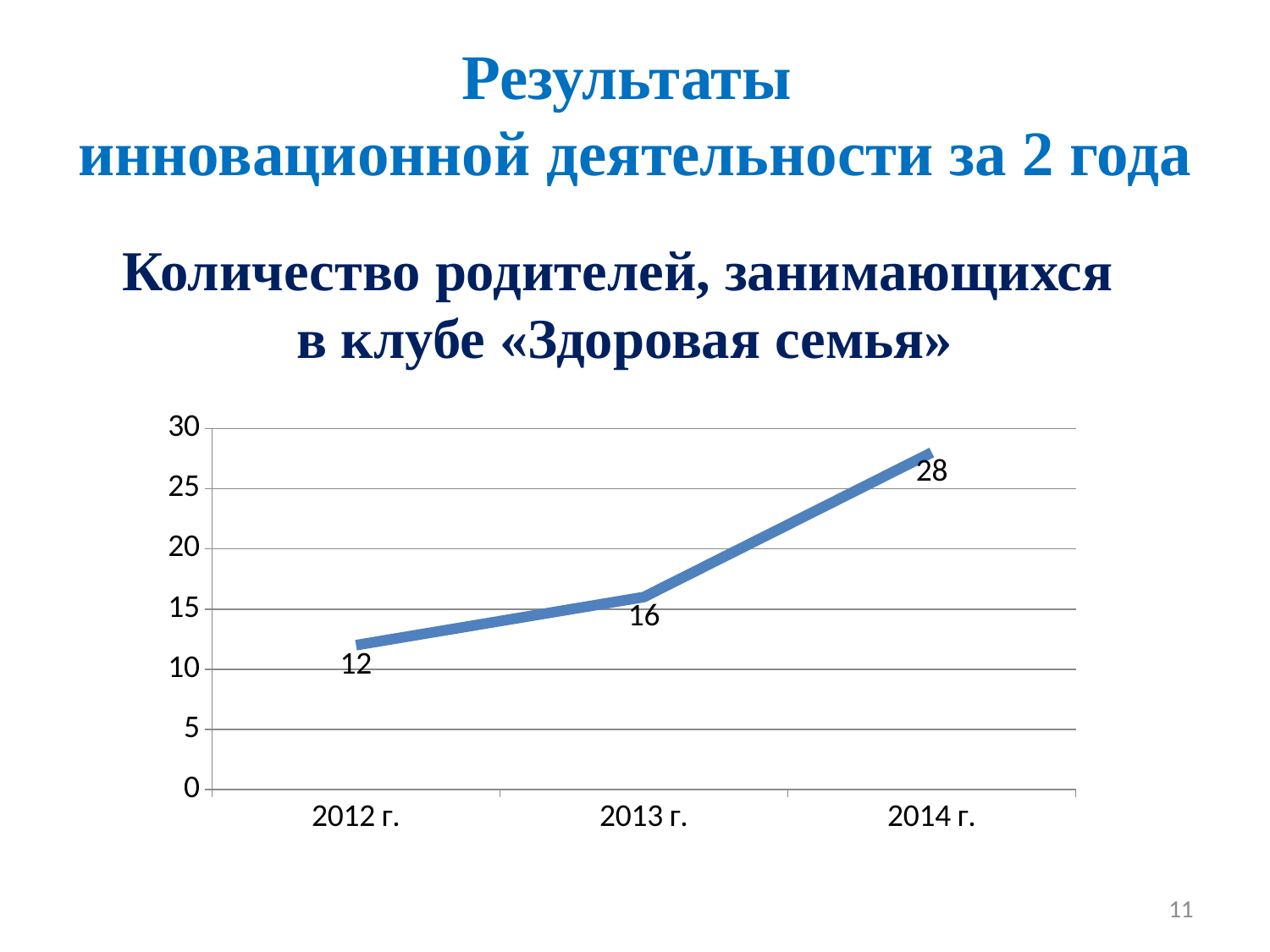
What is the value for 2014 г.? 28 How many years are plotted on the chart? 3 Which year has the highest value? 2014 г. Which year has the lowest value? 2012 г. What kind of chart is shown on the slide? line chart Do the values rise or fall from 2012 г. to 2014 г.? rise What is the difference between the values for 2013 г. and 2012 г.? 4 What is the value for 2013 г.? 16 Is the value for 2014 г. greater or less than 25? greater What is the value for 2012 г.? 12 Which is larger, the value for 2013 г. or the value for 2014 г.? 2014 г. What is the difference between the values for 2014 г. and 2012 г.? 16